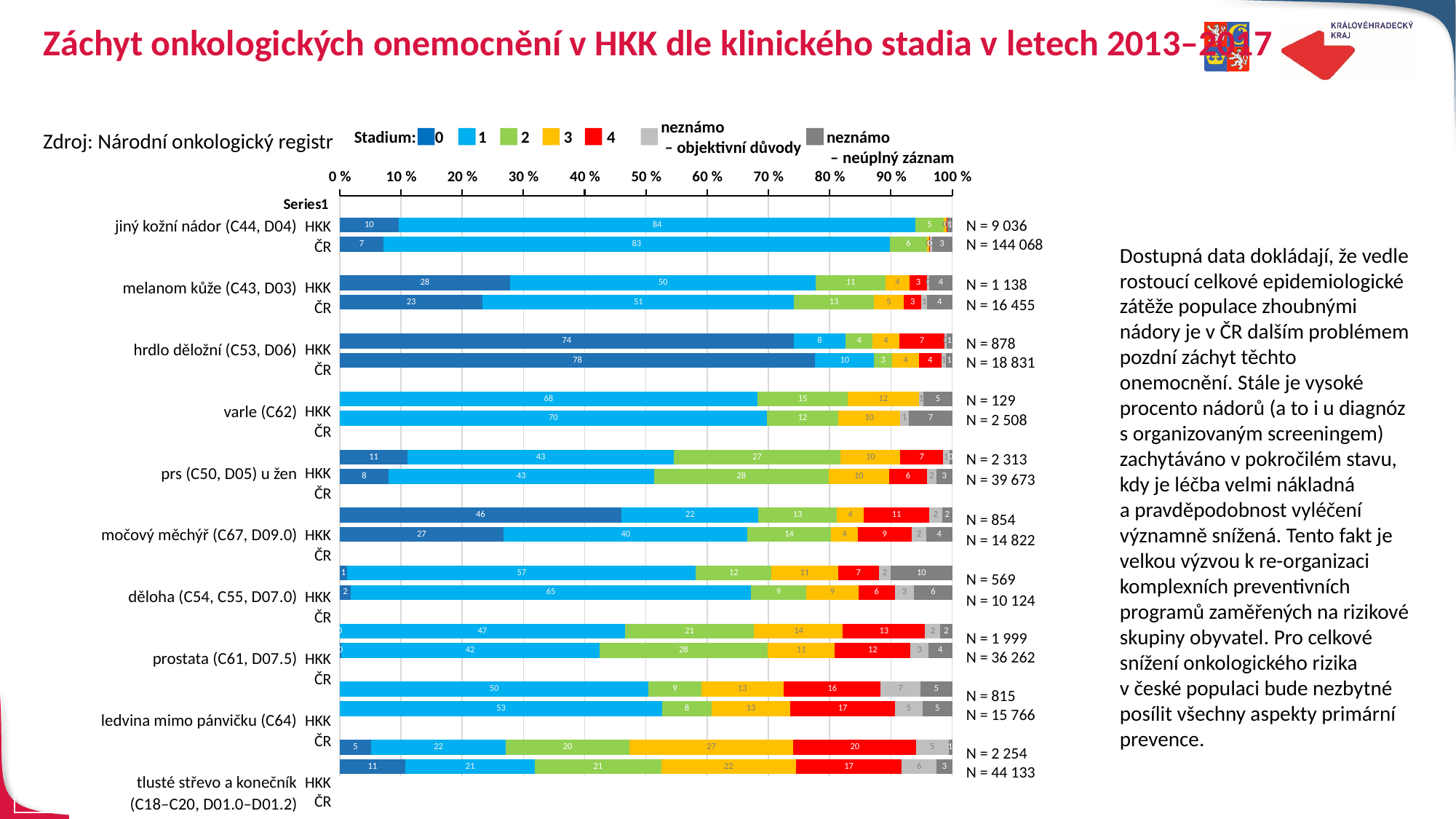
What percentage of tlusté střevo a konečník (C18–C20, D01.0–D01.2) cases in HKK were detected at stage 4? 20 What kind of chart is shown on the slide? stacked bar chart What is the source of the data stated on the slide? Národní onkologický registr Which has a larger share of stage 0 for močový měchýř (C67, D09.0): HKK or ČR? HKK How many cancer diagnoses (categories) are shown in the chart? 10 What percentage of melanom kůže (C43, D03) cases in HKK were detected at stage 0? 28 What percentage of hrdlo děložní (C53, D06) cases in ČR were detected at stage 0? 78 What is the N value for jiný kožní nádor (C44, D04) in ČR? N = 144 068 What is the difference in the stage 0 share for močový měchýř (C67, D09.0) between HKK (46) and ČR (27)? 19 What percentage of prs (C50, D05) u žen cases in ČR were detected at stage 2? 28 How many series does the legend (Stadium) list? 7 What is the N value for varle (C62) in HKK? N = 129